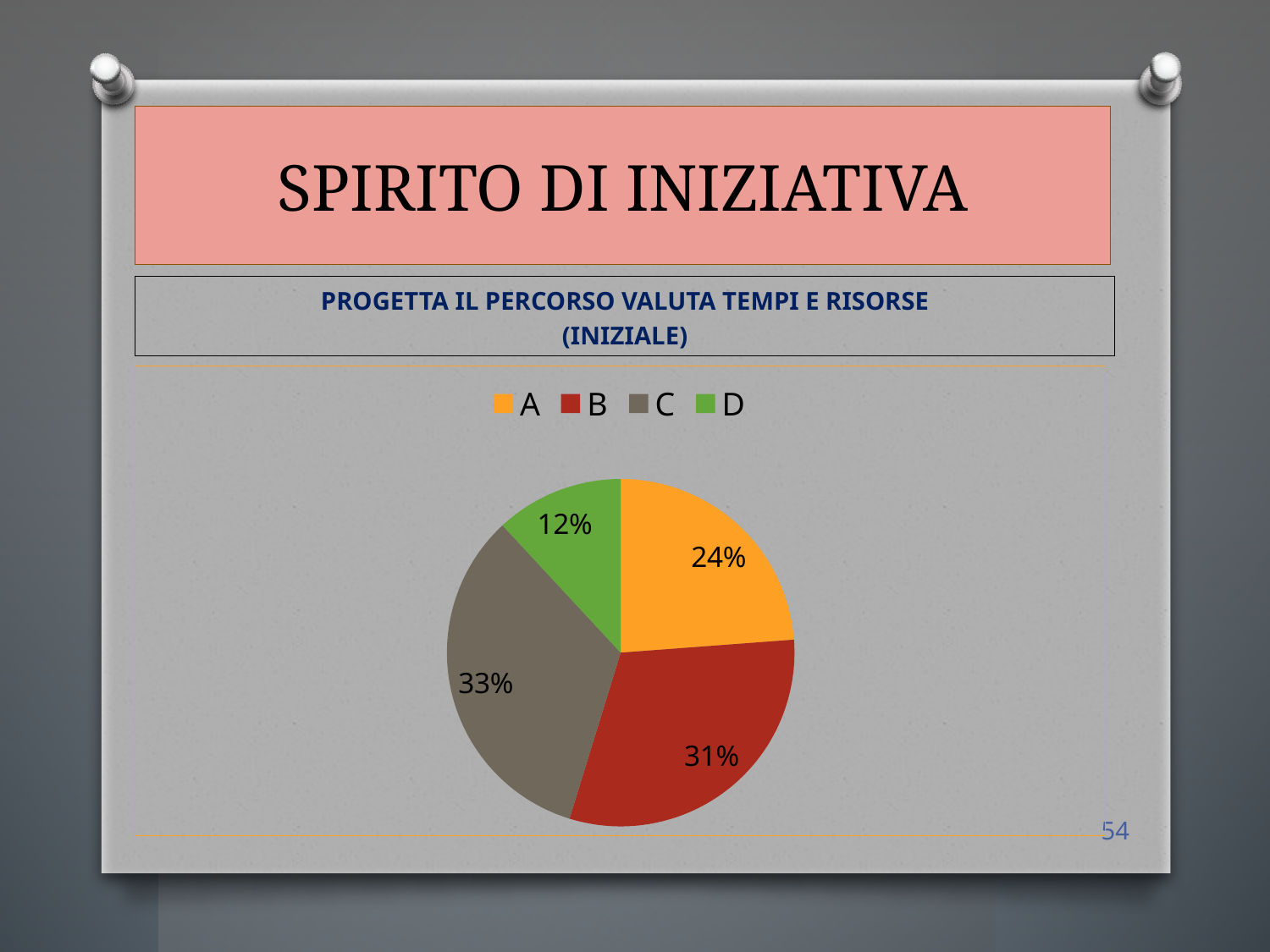
What colour is the slice for category D? green Which category has the smallest slice of the pie? D What is the combined share of categories A and B? 55% Which category has the largest slice of the pie? C How many categories does the legend list? 4 What is the difference in percentage points between category C and category D? 21 Which is larger, the slice for A or the slice for B? B What share of the pie does category C have? 33% What share of the pie does category B have? 31% What kind of chart is shown on the slide? pie chart What share of the pie does category D have? 12% What share of the pie does category A have? 24%